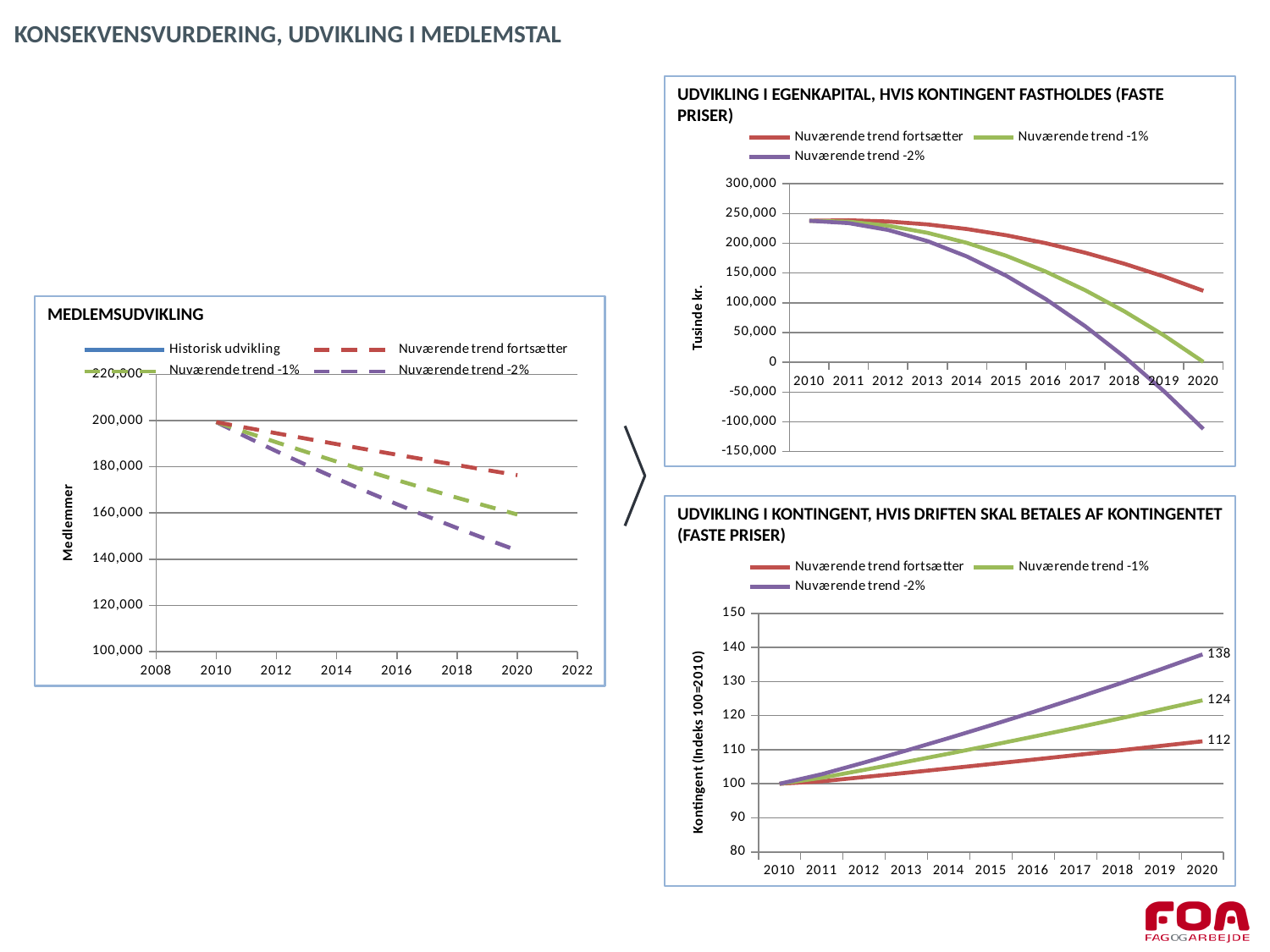
In the chart titled 'UDVIKLING I KONTINGENT, HVIS DRIFTEN SKAL BETALES AF KONTINGENTET (FASTE PRISER)', what is the value for 'Nuværende trend -2%' in 2020? 138 In the chart titled 'UDVIKLING I KONTINGENT, HVIS DRIFTEN SKAL BETALES AF KONTINGENTET (FASTE PRISER)', do the values rise or fall from 2010 to 2020? rise In the chart titled 'UDVIKLING I KONTINGENT, HVIS DRIFTEN SKAL BETALES AF KONTINGENTET (FASTE PRISER)', what is the value for 'Nuværende trend fortsætter' in 2020? 112 In the chart titled 'UDVIKLING I KONTINGENT, HVIS DRIFTEN SKAL BETALES AF KONTINGENTET (FASTE PRISER)', which series has the highest value in 2020? Nuværende trend -2% In the chart titled 'UDVIKLING I KONTINGENT, HVIS DRIFTEN SKAL BETALES AF KONTINGENTET (FASTE PRISER)', which is larger in 2020: 'Nuværende trend -1%' or 'Nuværende trend fortsætter'? Nuværende trend -1% In the chart titled 'UDVIKLING I EGENKAPITAL, HVIS KONTINGENT FASTHOLDES (FASTE PRISER)', is the value for 'Nuværende trend -2%' in 2020 greater or less than 0? less In the chart titled 'UDVIKLING I EGENKAPITAL, HVIS KONTINGENT FASTHOLDES (FASTE PRISER)', do the values rise or fall from 2010 to 2020? fall In the chart titled 'UDVIKLING I KONTINGENT, HVIS DRIFTEN SKAL BETALES AF KONTINGENTET (FASTE PRISER)', what is the difference between the 2020 values of 'Nuværende trend -2%' and 'Nuværende trend fortsætter'? 26 What kind of chart is the chart titled 'MEDLEMSUDVIKLING'? line chart In the chart titled 'MEDLEMSUDVIKLING', is the value for 'Nuværende trend -2%' in 2020 greater or less than 160,000? less In the chart titled 'UDVIKLING I EGENKAPITAL, HVIS KONTINGENT FASTHOLDES (FASTE PRISER)', is the value for 'Nuværende trend fortsætter' in 2020 greater or less than 100,000? greater How many series does the legend of the chart titled 'MEDLEMSUDVIKLING' list? 4